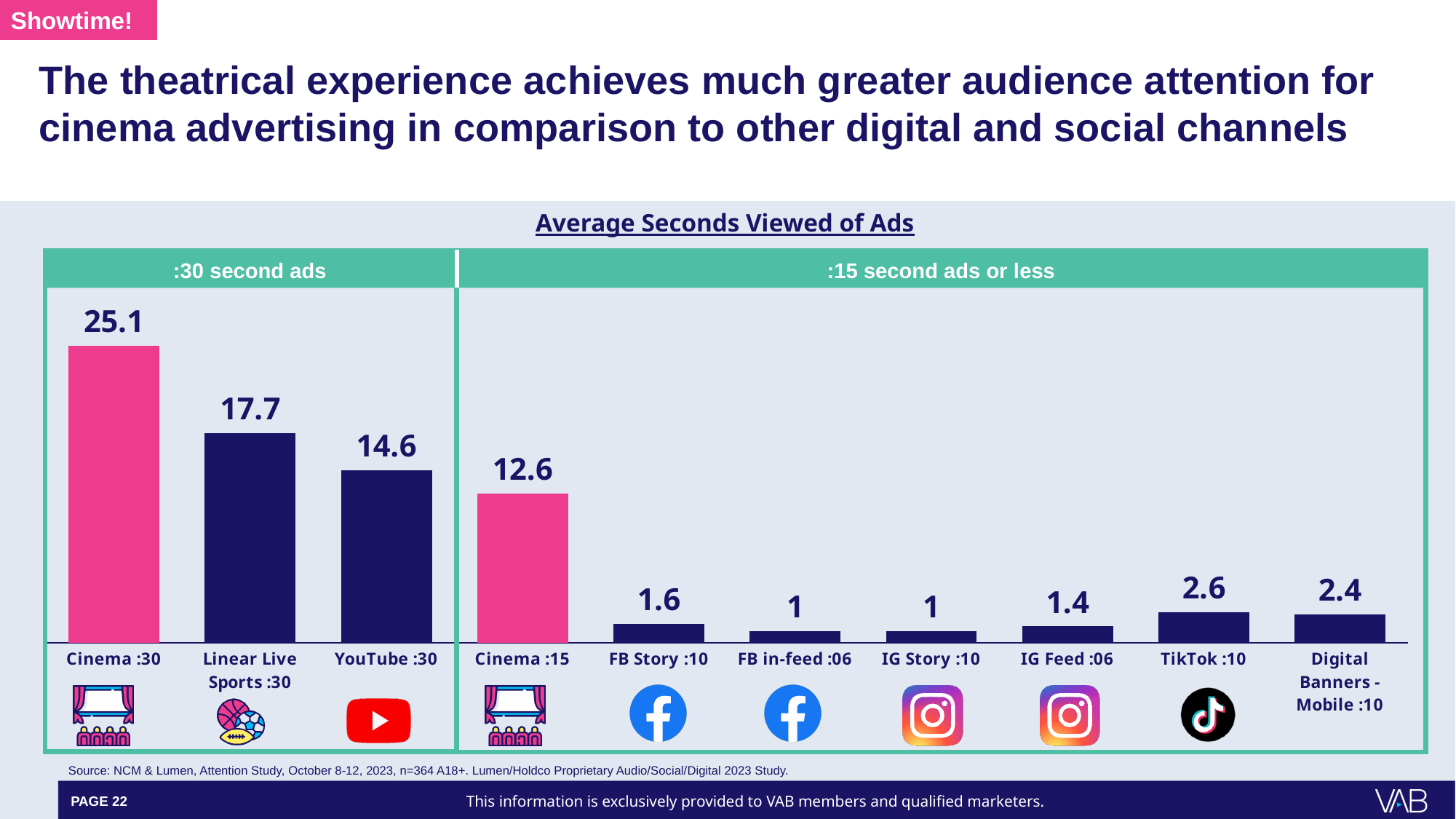
Which has a higher average seconds viewed, TikTok :10 or Digital Banners - Mobile :10? TikTok :10 What is the average seconds viewed for TikTok :10? 2.6 What is the title of the chart? Average Seconds Viewed of Ads What kind of chart is shown on the slide? Bar chart What is the average seconds viewed for Linear Live Sports :30? 17.7 What is the difference in average seconds viewed between Cinema :15 and FB Story :10? 11 Which category has the highest average seconds viewed among the :15 second ads or less group? Cinema :15 Which category has the highest average seconds viewed? Cinema :30 What is the average seconds viewed for Cinema :30? 25.1 What is the average seconds viewed for IG Feed :06? 1.4 How many categories are plotted in the chart? 10 What is the difference in average seconds viewed between Cinema :30 and YouTube :30? 10.5